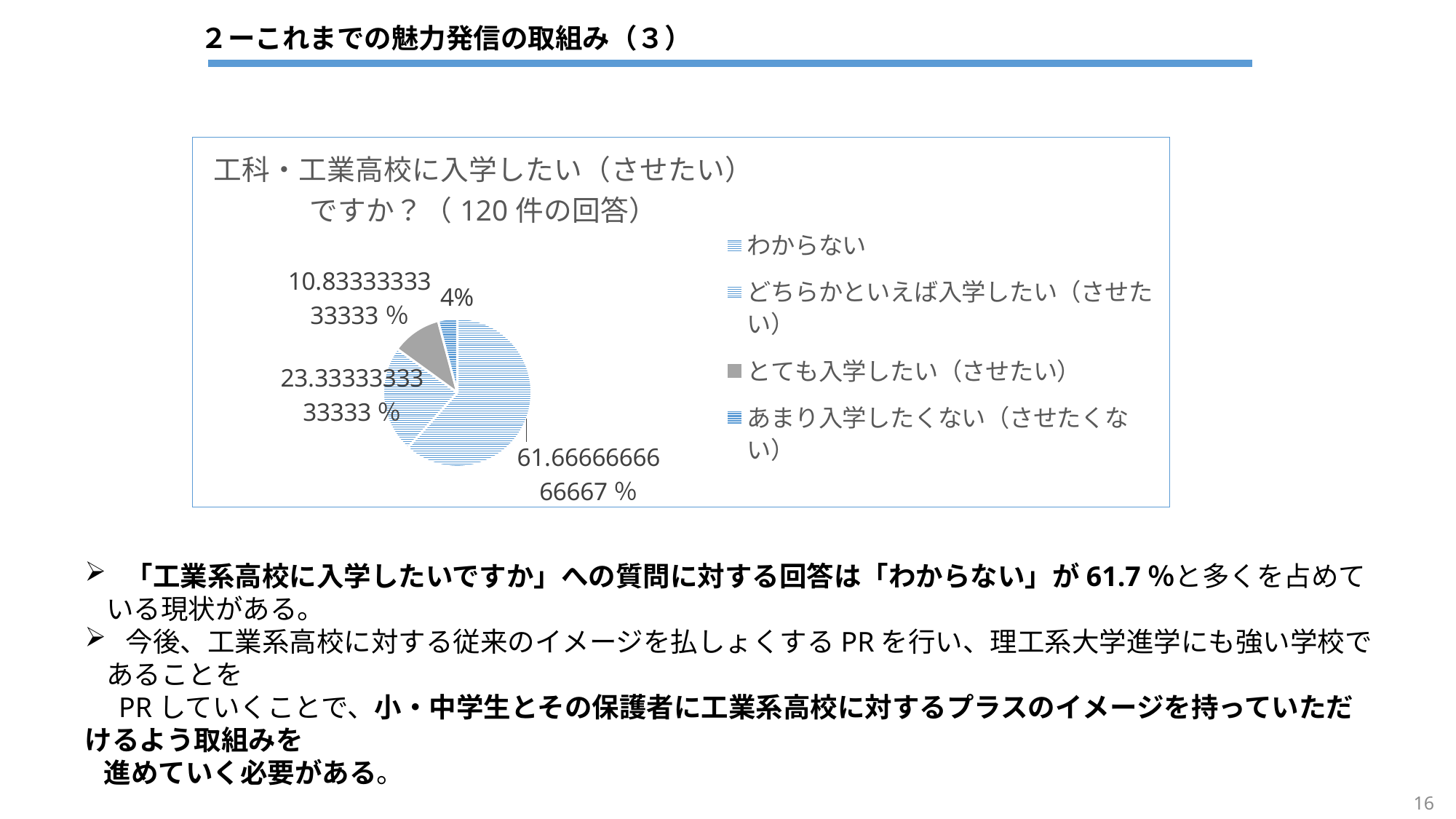
What share of the pie does 「あまり入学したくない（させたくない）」 have? 4% How many categories does the legend of the pie chart list? 4 What share of the pie does 「どちらかといえば入学したい（させたい）」 have? 23.3333333333333 % What share of the pie does 「わからない」 have? 61.6666666666667 % How many responses does the chart title say were collected? 120件 Which category has the smallest slice of the pie? あまり入学したくない（させたくない） What is the title of the pie chart? 工科・工業高校に入学したい（させたい）ですか？（120件の回答） What kind of chart is shown on the slide? pie chart Which slice is larger: 「どちらかといえば入学したい（させたい）」 or 「とても入学したい（させたい）」? どちらかといえば入学したい（させたい） Which category has the largest slice of the pie? わからない Which category is shown in solid gray in the pie chart? とても入学したい（させたい）